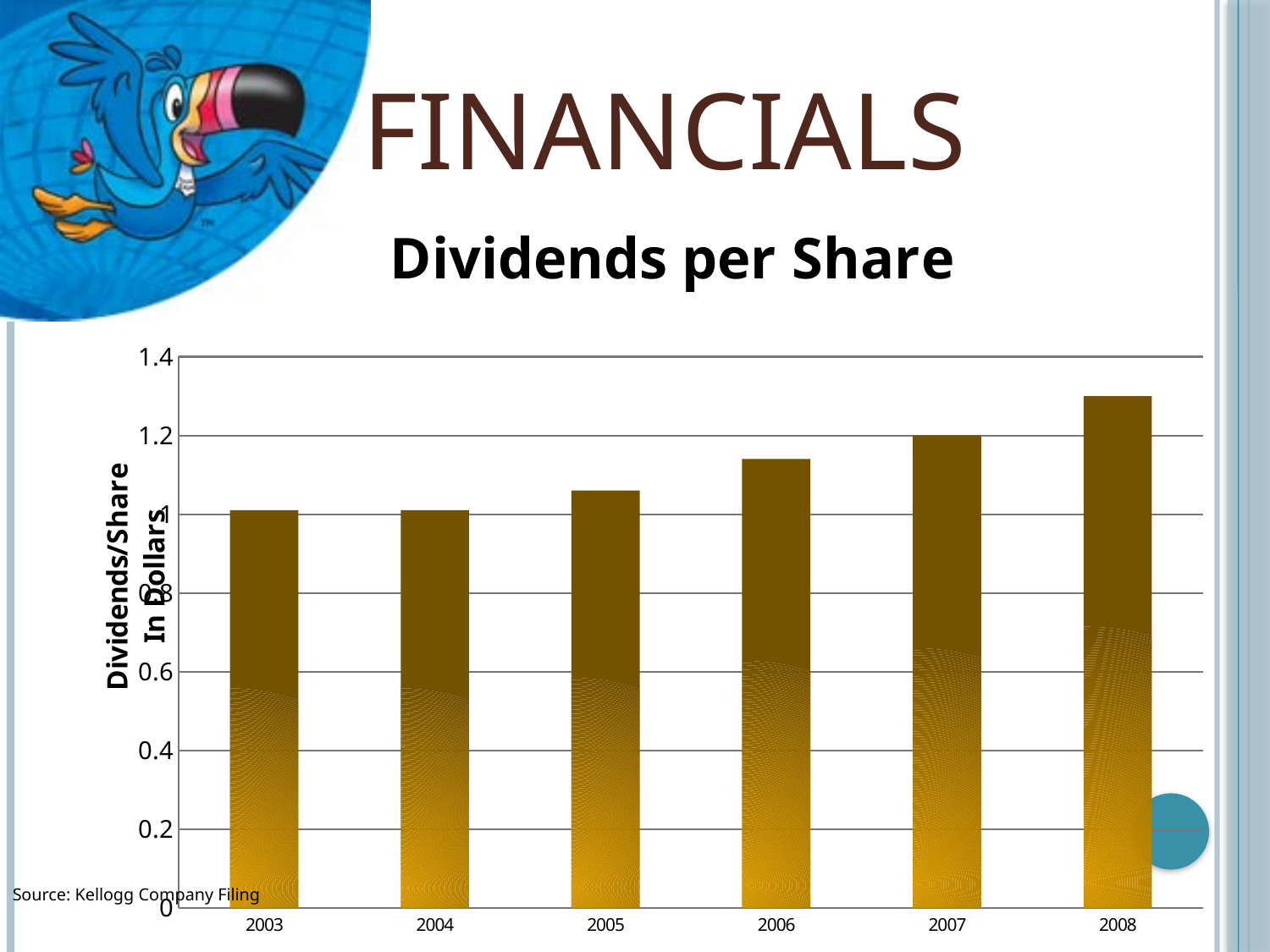
Is the value for 2003 greater or less than 0.8? greater Which year has the highest dividends per share? 2008 Is the value for 2005 greater or less than 1.2? less Which is larger, the dividends per share for 2005 or for 2008? 2008 Is the value for 2008 greater or less than 1.2? greater How many years are shown on the x axis of the Dividends per Share chart? 6 What kind of chart is shown on the slide? bar chart What source is cited for the chart data? Kellogg Company Filing What is the title of the chart? Dividends per Share Do dividends per share rise or fall from 2003 to 2008? rise